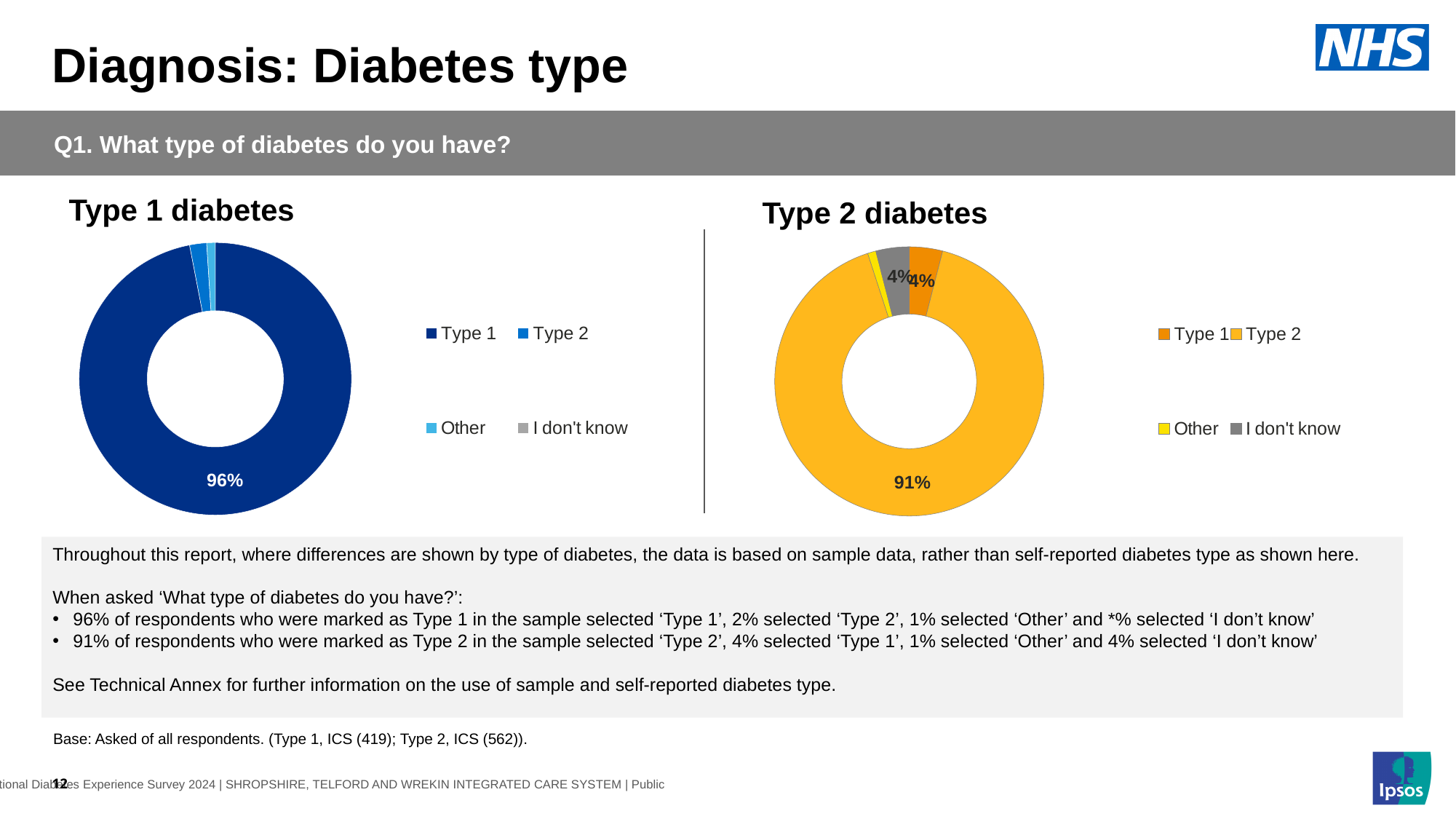
Which is larger: the 'Type 1' share in the Type 1 diabetes chart or the 'Type 2' share in the Type 2 diabetes chart? The 'Type 1' share in the Type 1 diabetes chart (96%) What kind of chart is the Type 1 diabetes chart? Pie (donut) chart How many categories does the legend of the Type 2 diabetes chart list? 4 In the Type 2 diabetes chart, what is the difference in percentage points between the 'Type 2' slice and the 'Type 1' slice? 87 percentage points In the Type 2 diabetes chart, what percentage of respondents selected 'I don't know'? 4% In the Type 1 diabetes chart, what percentage of respondents selected 'Type 1'? 96% In the Type 1 diabetes chart, what colour is the 'Type 1' slice? Dark blue In the Type 2 diabetes chart, what percentage of respondents selected 'Type 2'? 91% In the Type 2 diabetes chart, what percentage of respondents selected 'Type 1'? 4% In the Type 2 diabetes chart, which category has the smallest slice? Other In the Type 2 diabetes chart, which category has the largest slice? Type 2 In the Type 1 diabetes chart, which category has the largest slice? Type 1